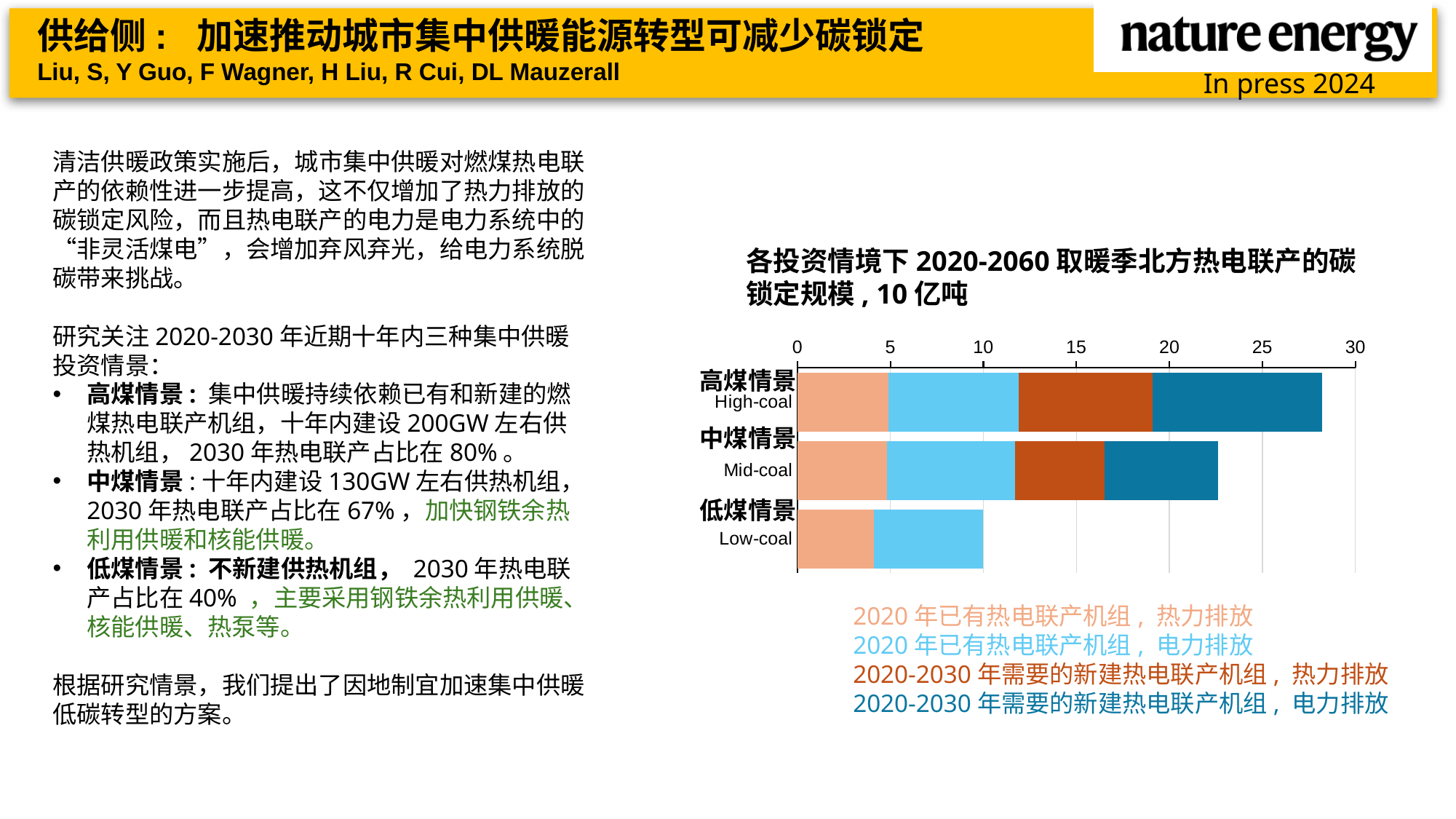
What unit is stated in the chart title for the carbon lock-in scale? 10 亿吨 How many scenarios (categories) are plotted in the chart? 3 How many series does the chart's legend list? 4 Is the total bar for the High-coal scenario greater or less than 25? greater Which scenario has the shortest total bar? 低煤情景 (Low-coal) What kind of chart is shown on the slide? bar chart Is the total bar for the Low-coal scenario greater or less than 15? less Which scenario's bar contains only two colored segments? 低煤情景 (Low-coal) Which scenario has a larger total carbon lock-in, Mid-coal or Low-coal? Mid-coal Is the total bar for the Mid-coal scenario greater or less than 20? greater What is the maximum value shown on the chart's horizontal axis? 30 Which scenario has the longest total bar? 高煤情景 (High-coal)